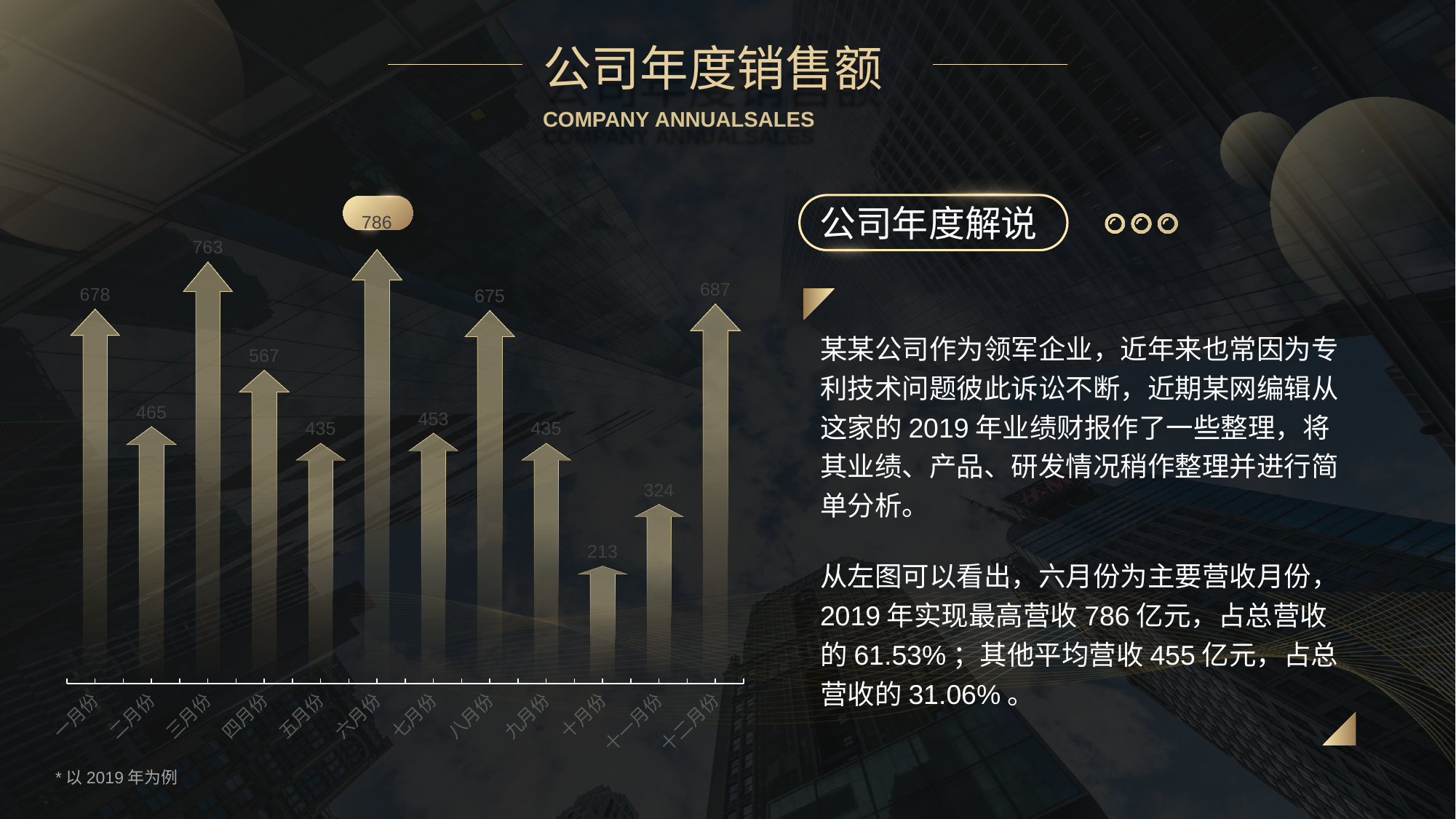
What is the value for 十二月份 (December)? 687 Which month has the highest value? 六月份 How many months are shown on the x axis? 12 What is the value for 十月份 (October)? 213 What is the difference between the values for 六月份 (June) and 三月份 (March)? 23 What is the value for 六月份 (June)? 786 What is the value for 三月份 (March)? 763 Which is larger, the value for 四月份 (April) or 十一月份 (November)? 四月份 What is the title of the slide containing the chart? 公司年度销售额 What is the difference between the values for 一月份 (January) and 二月份 (February)? 213 What kind of chart is this? bar chart Which month has the lowest value? 十月份